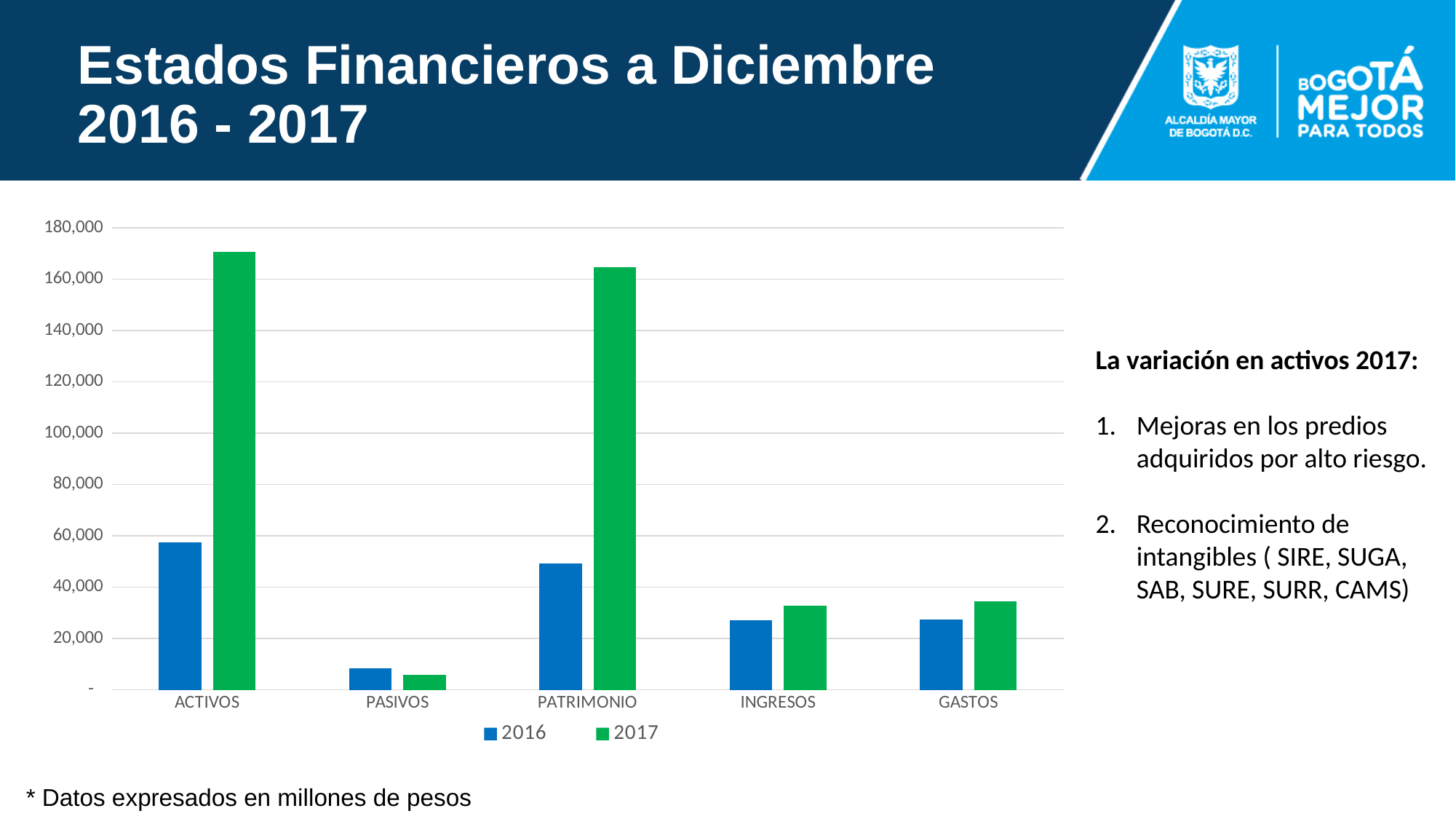
What kind of chart is shown on the slide? Bar chart Which category has the lowest value for the 2017 series? PASIVOS How many categories are shown on the x axis of the chart? 5 For ACTIVOS, which series has the larger value, 2016 or 2017? 2017 For PASIVOS, which series has the larger value, 2016 or 2017? 2016 Which category has the highest value for the 2016 series? ACTIVOS Which colour represents the 2017 series in the chart? Green How many series does the chart legend list? 2 Is the 2016 value for PATRIMONIO greater or less than 60,000? less Which category has the lowest value for the 2016 series? PASIVOS Is the 2017 value for ACTIVOS greater or less than 160,000? greater Which category has the highest value for the 2017 series? ACTIVOS